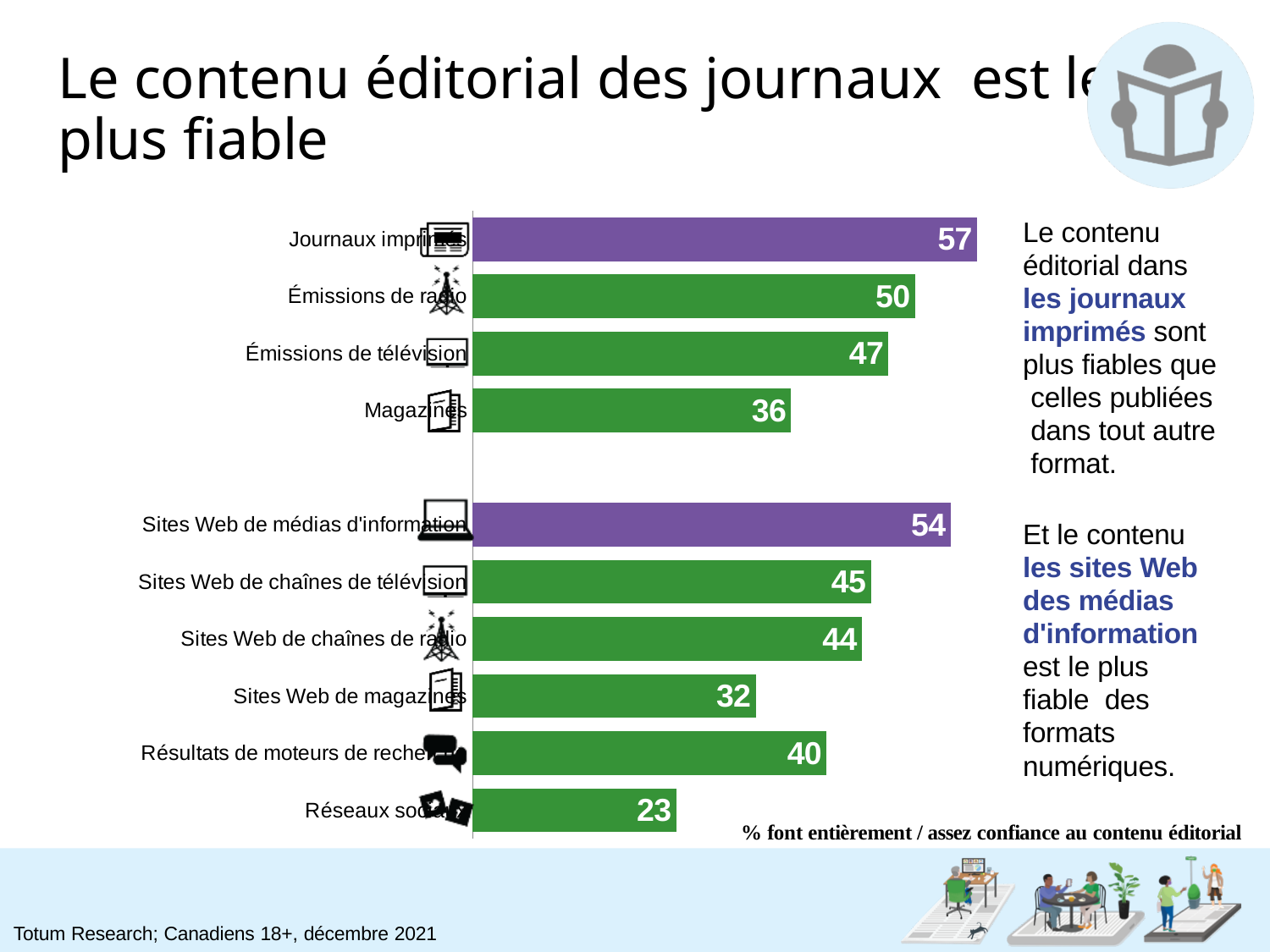
What is the value for Résultats de moteurs de recherche? 40 What is the value for Journaux imprimés? 57 What kind of chart is shown on the slide? Bar chart What is the difference between the values for Émissions de radio and Réseaux sociaux? 27 Which category has the highest value? Journaux imprimés Which two bars are coloured purple rather than green? Journaux imprimés and Sites Web de médias d'information What is the value for Réseaux sociaux? 23 Which is larger, the value for Magazines or the value for Sites Web de magazines? Magazines What is the value for Sites Web de médias d'information? 54 Which category has the lowest value? Réseaux sociaux What is the difference between the values for Journaux imprimés and Sites Web de médias d'information? 3 How many categories are shown in the chart? 10